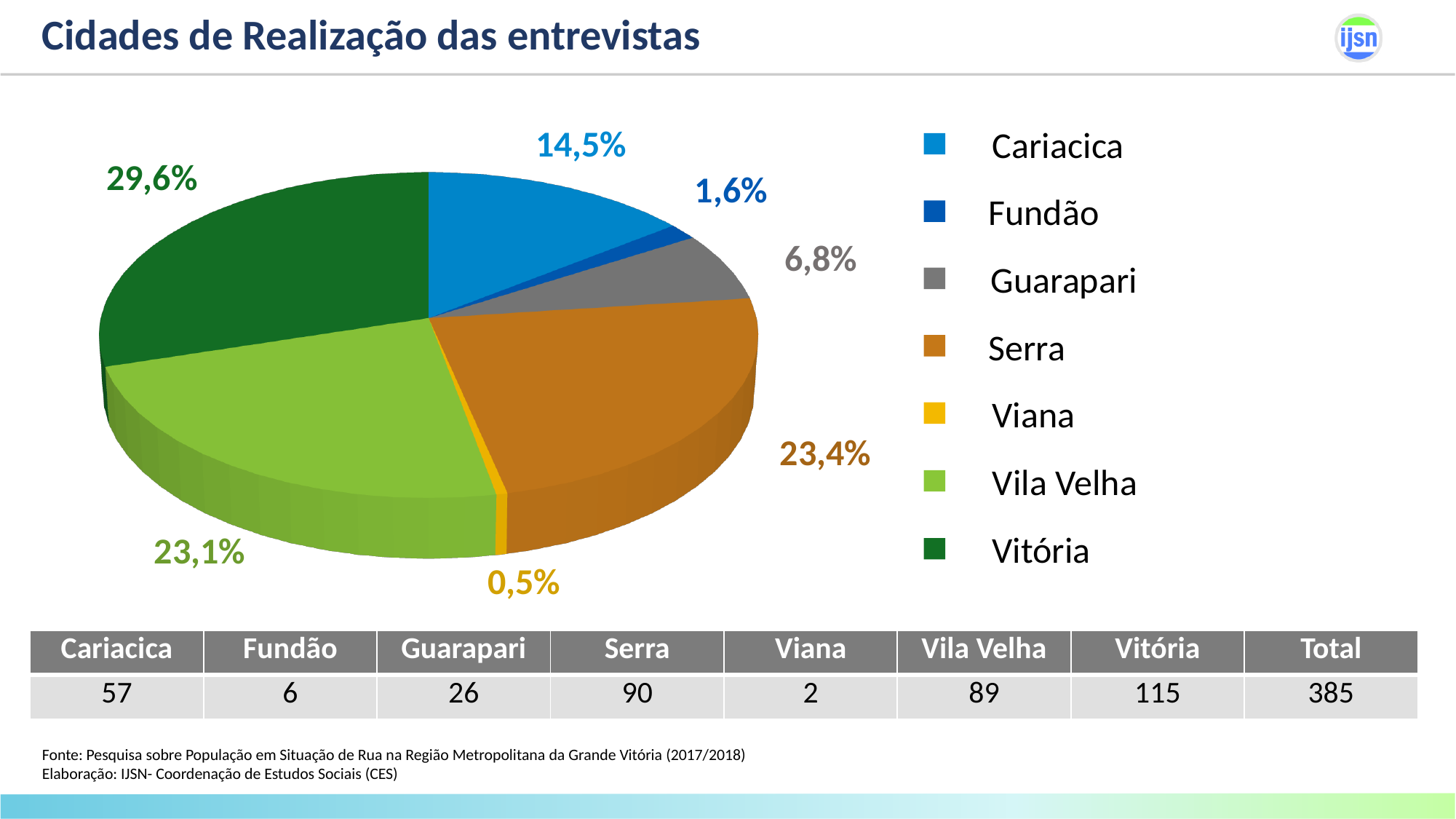
Which city has the largest slice of the pie? Vitória What percentage is shown for Guarapari? 6,8% What type of chart is shown on the slide? Pie chart What colour is the Serra slice in the pie chart? Orange Which slice is larger, Serra or Vila Velha? Serra Which slice is larger, Cariacica or Fundão? Cariacica What is the difference in percentage points between Vitória and Serra? 6,2 What is the difference in percentage points between Cariacica and Guarapari? 7,7 What share of the pie does Vitória represent? 29,6% How many cities are shown in the pie chart? 7 What percentage is shown for Cariacica in the pie chart? 14,5% Which city has the smallest slice of the pie? Viana